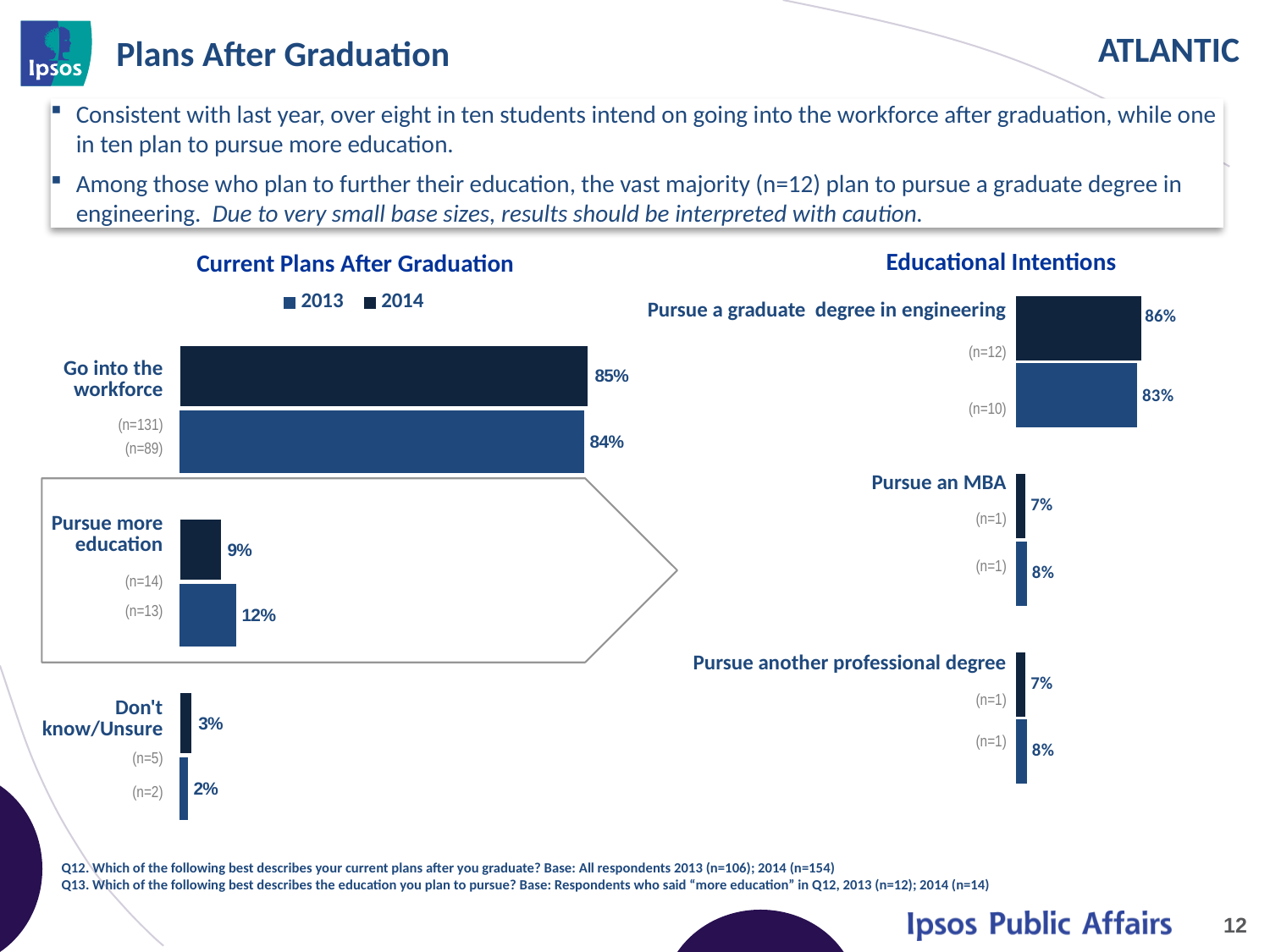
In the Educational Intentions chart, what is the value of the top (dark blue) bar for Pursue a graduate degree in engineering? 86% In the Current Plans After Graduation chart, what is the difference between the 2014 and 2013 values for Pursue more education? 3% How many series does the legend of the Current Plans After Graduation chart list? 2 In the Current Plans After Graduation chart, which category has the lowest 2014 value? Don't know/Unsure How many categories are shown in the Current Plans After Graduation chart? 3 In the Current Plans After Graduation chart, which category has the highest 2013 value? Go into the workforce In the Educational Intentions chart, what is the value of the lower (lighter blue) bar for Pursue an MBA? 8% What kind of chart is the Educational Intentions chart? Bar chart